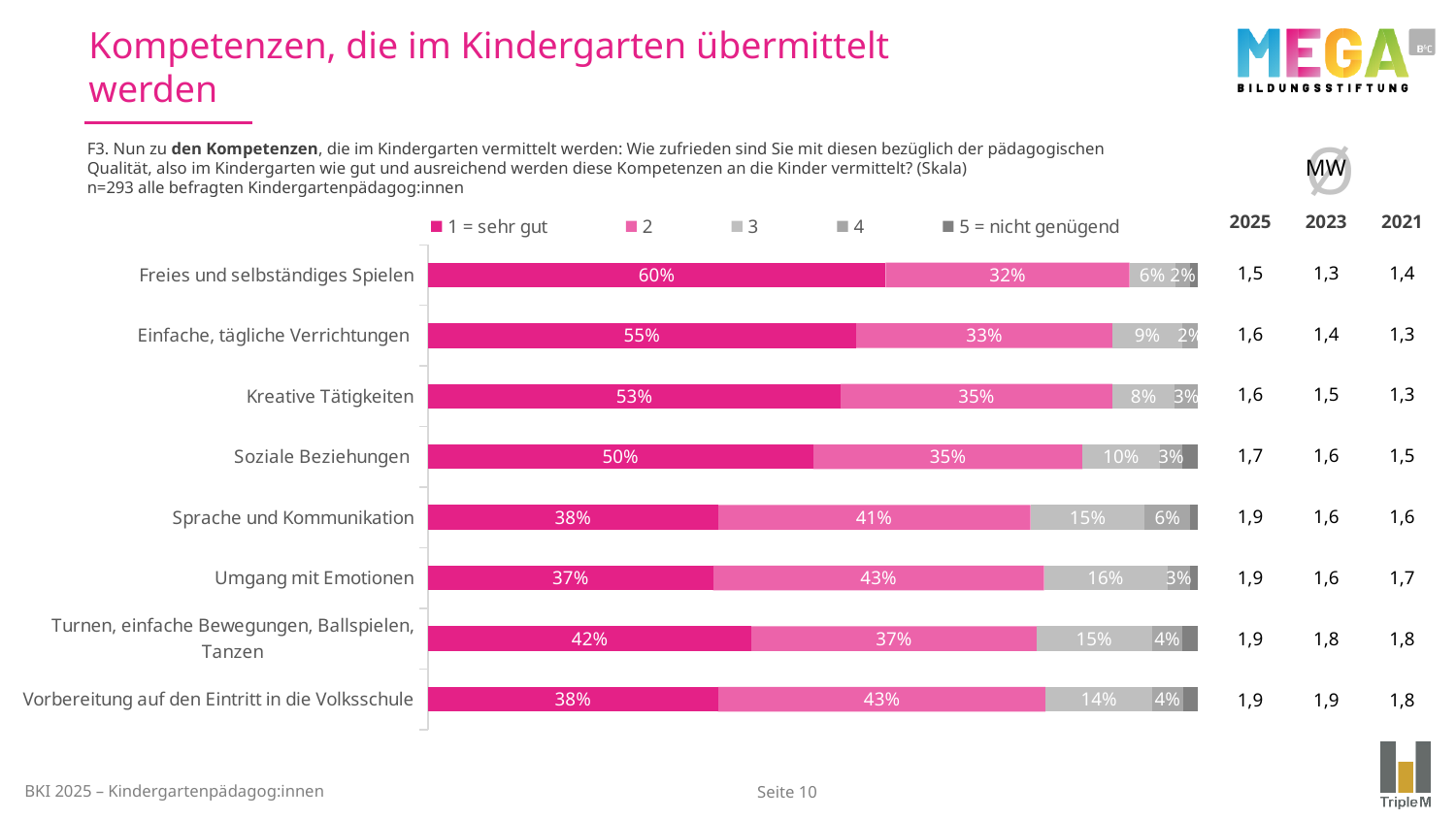
What is the value of "1 = sehr gut" for "Freies und selbständiges Spielen"? 60% What is the value of "2" for "Umgang mit Emotionen"? 43% What kind of chart is shown on the slide? stacked bar chart What is the difference between the "1 = sehr gut" values for "Freies und selbständiges Spielen" and "Kreative Tätigkeiten"? 7% What is the value of "3" for "Sprache und Kommunikation"? 15% Which is larger: the "1 = sehr gut" value for "Turnen, einfache Bewegungen, Ballspielen, Tanzen" or for "Vorbereitung auf den Eintritt in die Volksschule"? Turnen, einfache Bewegungen, Ballspielen, Tanzen How many categories are plotted in the chart? 8 What is the value of "4" for "Soziale Beziehungen"? 3% How many series does the legend list? 5 Which category has the highest value for "1 = sehr gut"? Freies und selbständiges Spielen Which category has the lowest value for "1 = sehr gut"? Umgang mit Emotionen What is the legend label of the darkest grey series? 5 = nicht genügend